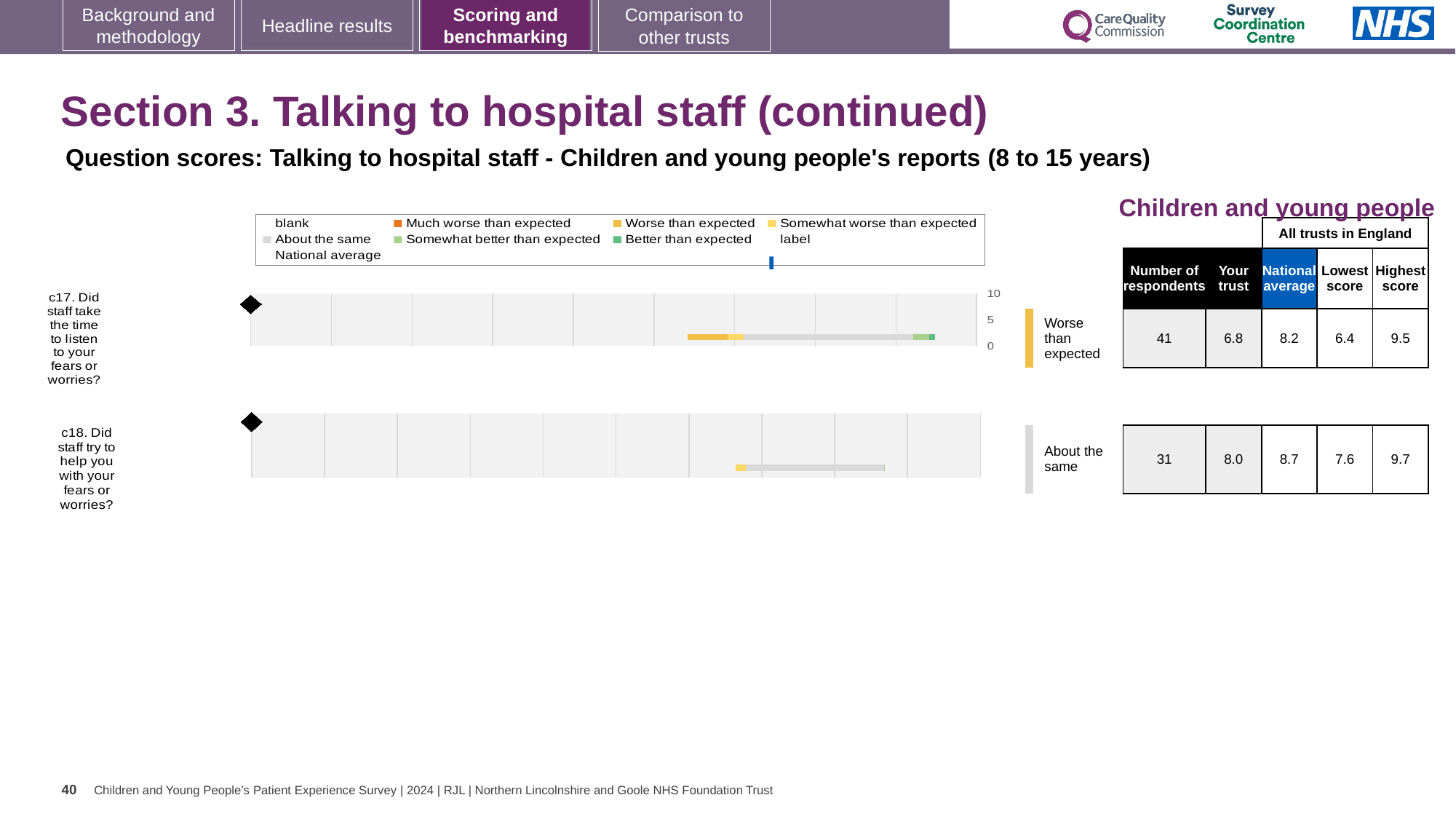
What kind of chart is used to show the question scores for c17 and c18? bar chart What is the national average score for c18 (Did staff try to help you with your fears or worries?)? 8.7 What is the lowest score across all trusts in England for c17? 6.4 How many respondents answered c17? 41 What is the difference between the national average and the trust's score for c17? 1.4 What is the difference between the highest and lowest scores for c18? 2.1 How many questions (c17 and c18) are plotted on the slide? 2 What is the 'Your trust' score for c17 (Did staff take the time to listen to your fears or worries?)? 6.8 Is the trust's score for c17 greater or less than 5 on the chart axis? greater What benchmark category is shown for c17? Worse than expected What is the highest score across all trusts in England for c18? 9.7 Which question has the higher 'Your trust' score, c17 or c18? c18